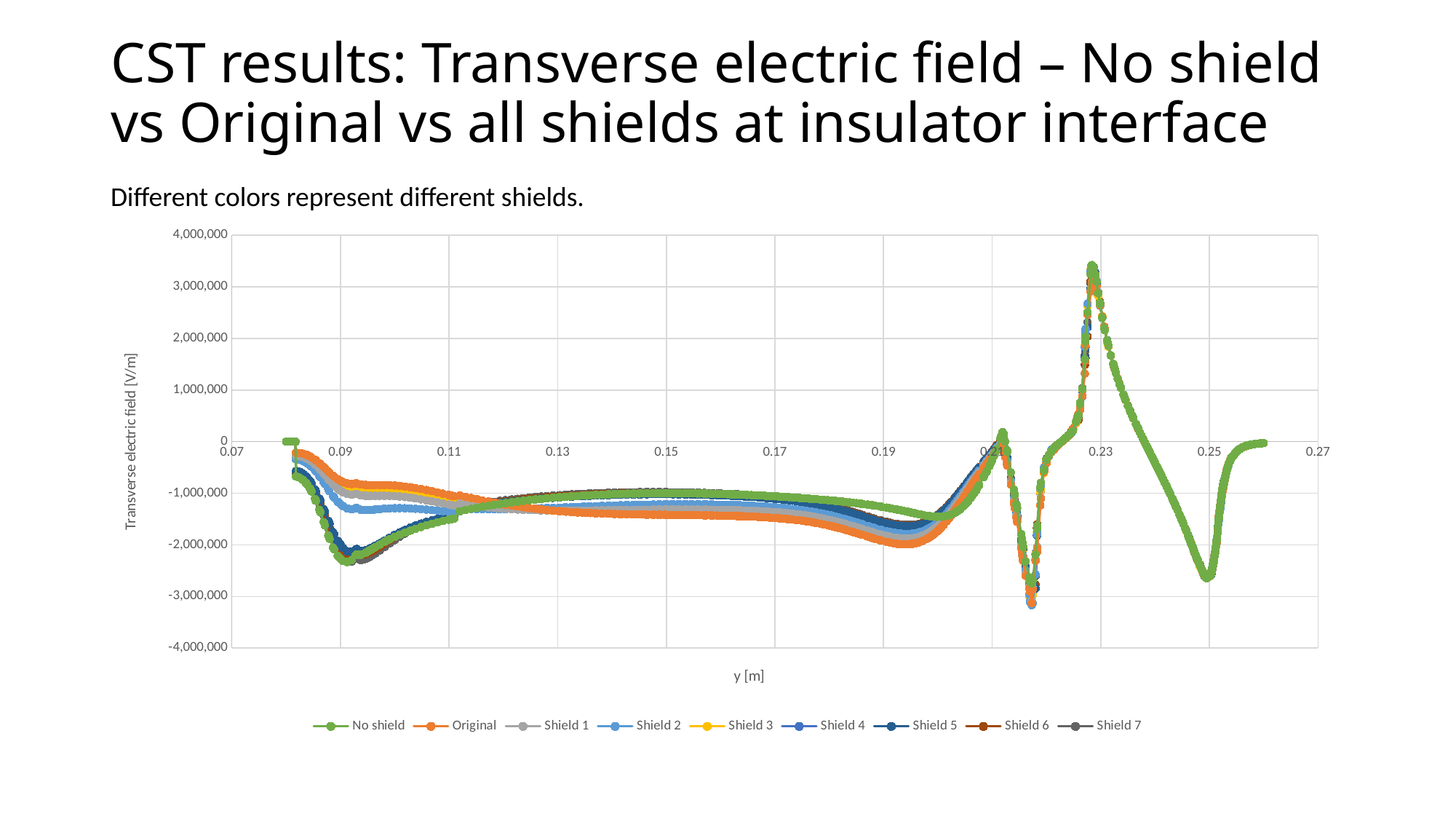
How many series does the legend list? 9 Is the value of the No shield series at y = 0.09 greater or less than -2,000,000? less Is the value of the Original series at y = 0.15 greater or less than -1,000,000? less What kind of chart is shown on the slide? Line chart Is the peak value of the No shield series near y = 0.23 greater or less than 3,000,000? greater At y = 0.09, which series has the larger value, No shield or Original? Original What is the label of the x axis? y [m] At y = 0.19, which series has the larger value, No shield or Original? No shield What is the label of the y axis? Transverse electric field [V/m] Which series is drawn in green? No shield Between y = 0.23 and y = 0.25, do the plotted values rise or fall? fall